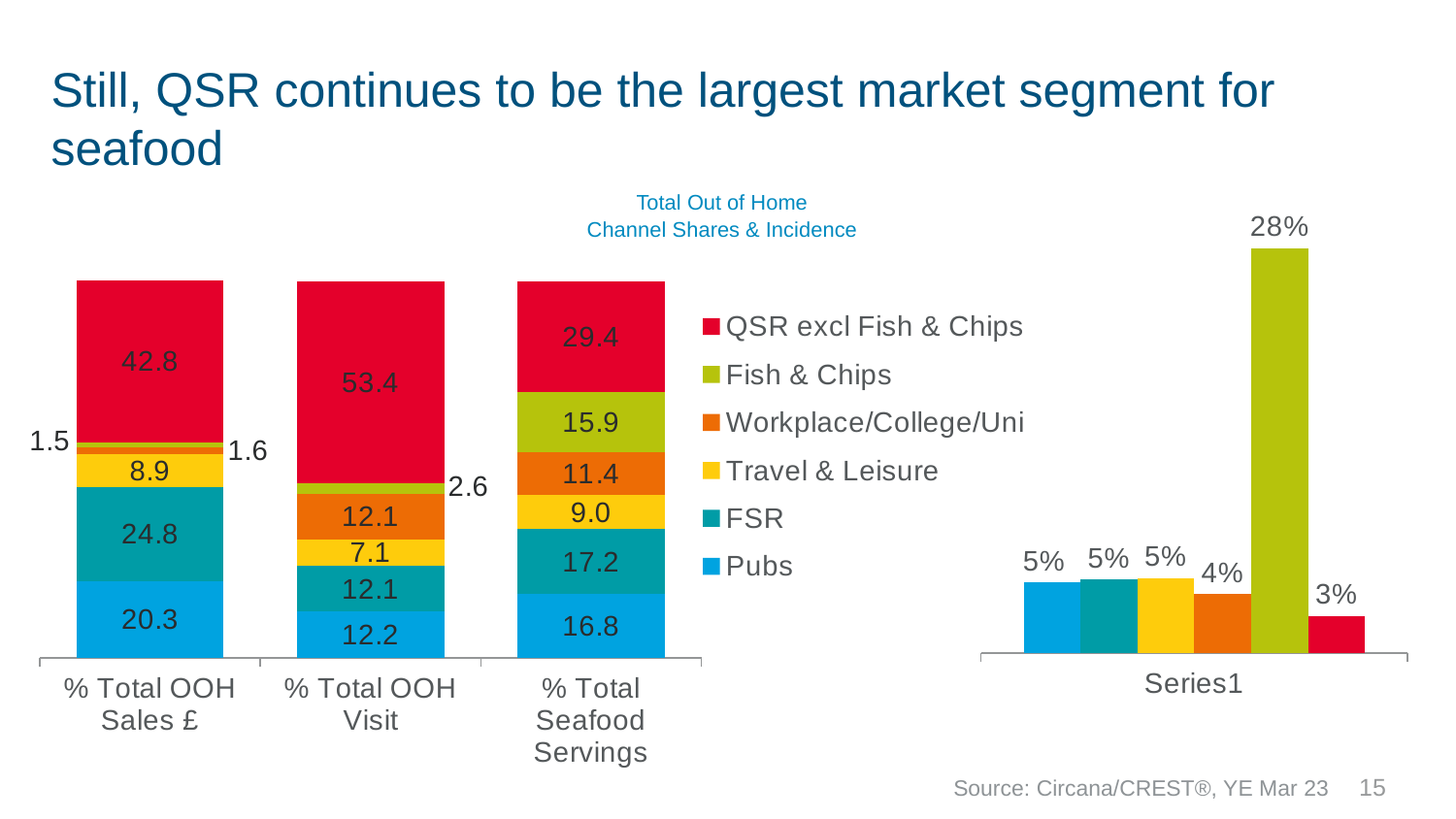
How many series does the legend of the 'Total Out of Home Channel Shares & Incidence' chart list? 6 In the 'Total Out of Home Channel Shares & Incidence' chart, what is the value for QSR excl Fish & Chips in the % Total OOH Visit bar? 53.4 In the 'Total Out of Home Channel Shares & Incidence' chart, is the FSR value larger for % Total OOH Sales £ or for % Total Seafood Servings? % Total OOH Sales £ In the 'Total Out of Home Channel Shares & Incidence' chart, what is the difference between the QSR excl Fish & Chips value for % Total OOH Visit and for % Total OOH Sales £? 10.6 In the 'Total Out of Home Channel Shares & Incidence' chart, what is the value for Workplace/College/Uni in the % Total Seafood Servings bar? 11.4 In the 'Total Out of Home Channel Shares & Incidence' chart, what is the value for Fish & Chips in the % Total Seafood Servings bar? 15.9 In the 'Total Out of Home Channel Shares & Incidence' chart, which segment is the largest in the % Total Seafood Servings bar? QSR excl Fish & Chips How many stacked bars (categories) are shown in the 'Total Out of Home Channel Shares & Incidence' chart? 3 In the chart on the right of the slide (Series1), what is the value of the highest bar? 28% What kind of chart is the 'Total Out of Home Channel Shares & Incidence' chart? Stacked bar chart How many bars are shown in the chart on the right of the slide (Series1)? 6 In the 'Total Out of Home Channel Shares & Incidence' chart, what is the value for Pubs in the % Total OOH Sales £ bar? 20.3